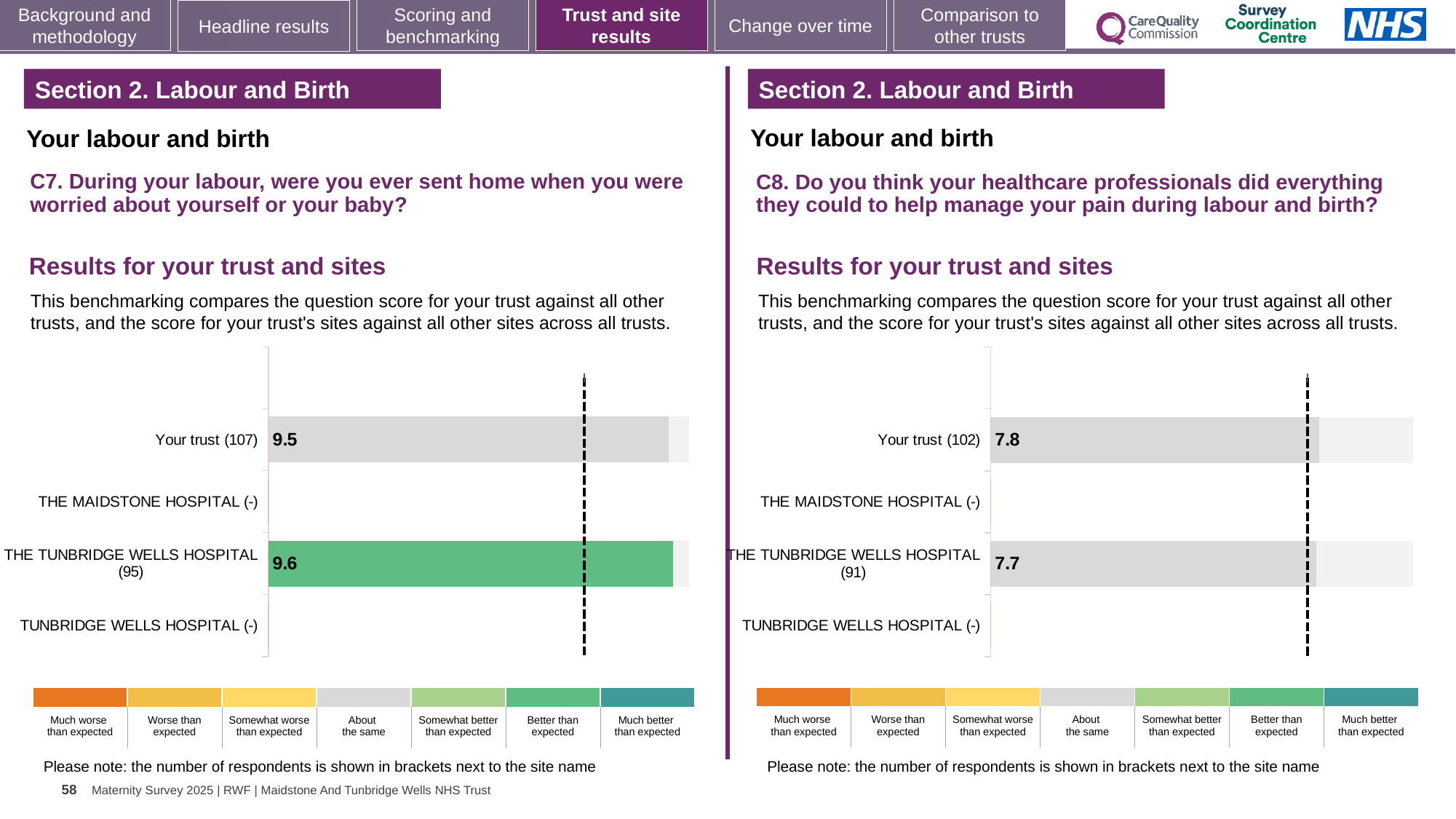
On the right chart (C8), what is the difference between the score for Your trust and the score for THE TUNBRIDGE WELLS HOSPITAL? 0.1 On the right chart (C8), what is the score for Your trust? 7.8 On the left chart (C7), what is the difference between the score for THE TUNBRIDGE WELLS HOSPITAL and the score for Your trust? 0.1 On the left chart (C7), what colour is the bar for THE TUNBRIDGE WELLS HOSPITAL? Green On the right chart (C8), how many benchmark categories does the colour legend below the chart list? 7 On the left chart (C7), how many respondents are shown in brackets for THE TUNBRIDGE WELLS HOSPITAL? 95 On the left chart (C7), what is the score for THE TUNBRIDGE WELLS HOSPITAL? 9.6 On the left chart (C7), what is the score for Your trust? 9.5 On the left chart (C7), how many site or trust categories are listed on the vertical axis? 4 What kind of chart is used on the left (C7) to show the results for your trust and sites? Bar chart On the right chart (C8), what is the score for THE TUNBRIDGE WELLS HOSPITAL? 7.7 On the right chart (C8), how many respondents are shown in brackets for Your trust? 102